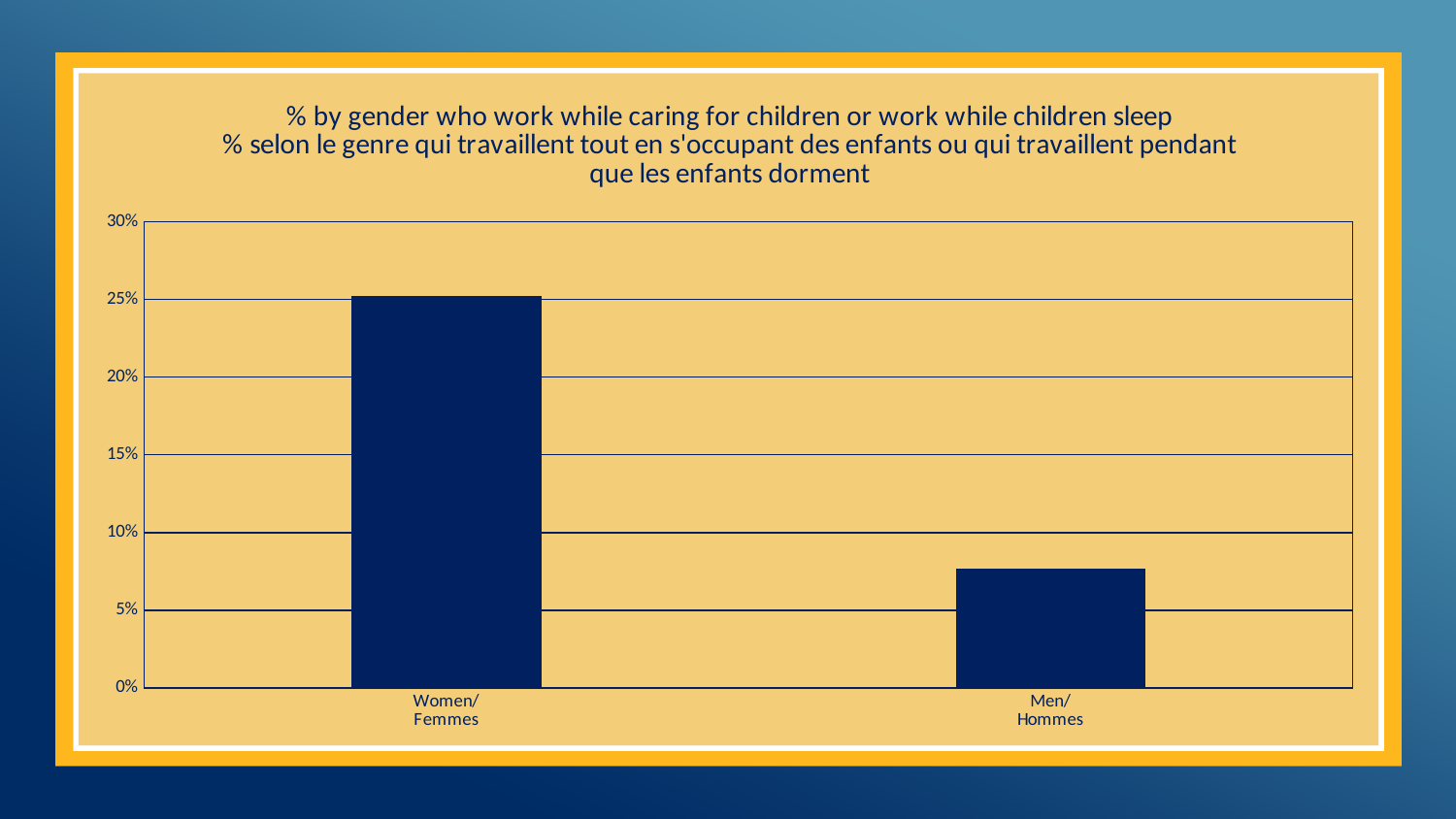
Which category has the lowest value in the chart? Men/Hommes Which is larger, the value for Women/Femmes or the value for Men/Hommes? Women/Femmes How many categories are shown on the x axis of the chart? 2 What is the English part of the chart's title? % by gender who work while caring for children or work while children sleep What kind of chart is shown on the slide? bar chart Which category has the highest value in the chart? Women/Femmes Is the value for Women/Femmes greater or less than 30%? less Is the value for Men/Hommes greater or less than 10%? less Is the value for Women/Femmes greater or less than 20%? greater What is the highest value shown on the y axis of the chart? 30%